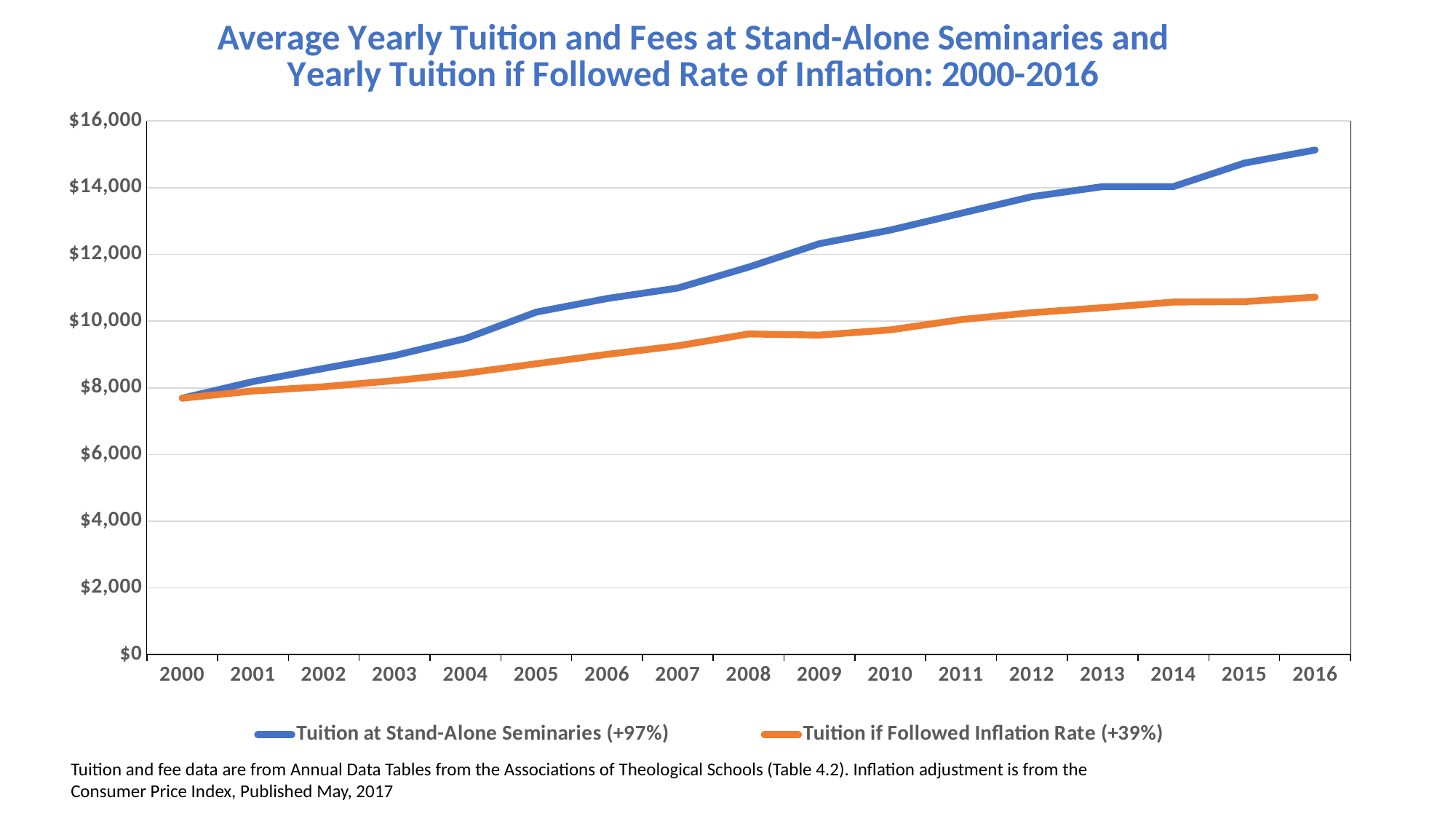
What kind of chart is shown on the slide? Line chart Does the Tuition at Stand-Alone Seminaries line rise or fall from 2000 to 2016? Rises Is the value for Tuition at Stand-Alone Seminaries in 2008 greater or less than $12,000? less In which year is Tuition if Followed Inflation Rate lowest? 2000 Is the value for Tuition at Stand-Alone Seminaries in 2000 greater or less than $8,000? less Is the value for Tuition at Stand-Alone Seminaries in 2016 greater or less than $14,000? greater How many years are plotted along the x axis? 17 What percentage increase does the legend give for Tuition at Stand-Alone Seminaries? +97% In 2016, which series has the larger value: Tuition at Stand-Alone Seminaries or Tuition if Followed Inflation Rate? Tuition at Stand-Alone Seminaries In which year is Tuition at Stand-Alone Seminaries highest? 2016 How many series does the legend list? 2